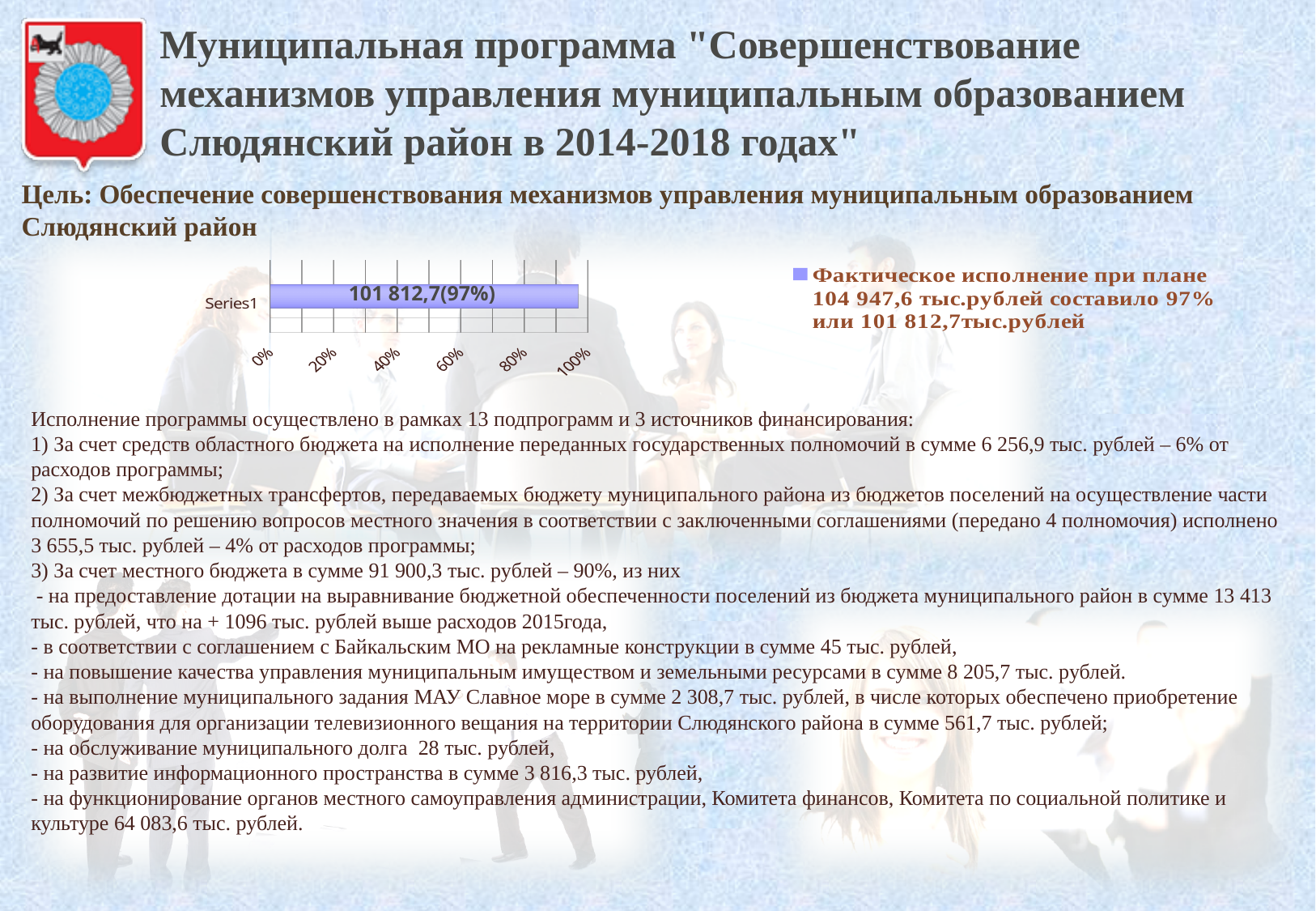
What data label is printed on the bar for Series1? 101 812,7(97%) How many series does the chart legend list? 1 Is the value for Series1 greater or less than 80%? greater How many bars does the chart contain? 1 What percentage of the plan does the bar for Series1 represent, according to its data label? 97% What kind of chart is shown on the slide? bar chart Is the value for Series1 greater or less than 100%? less According to the chart legend, what was the planned amount in thousand rubles? 104 947,6 тыс.рублей What is the highest tick value shown on the horizontal axis of the chart? 100% What is the category label shown on the vertical axis of the chart? Series1